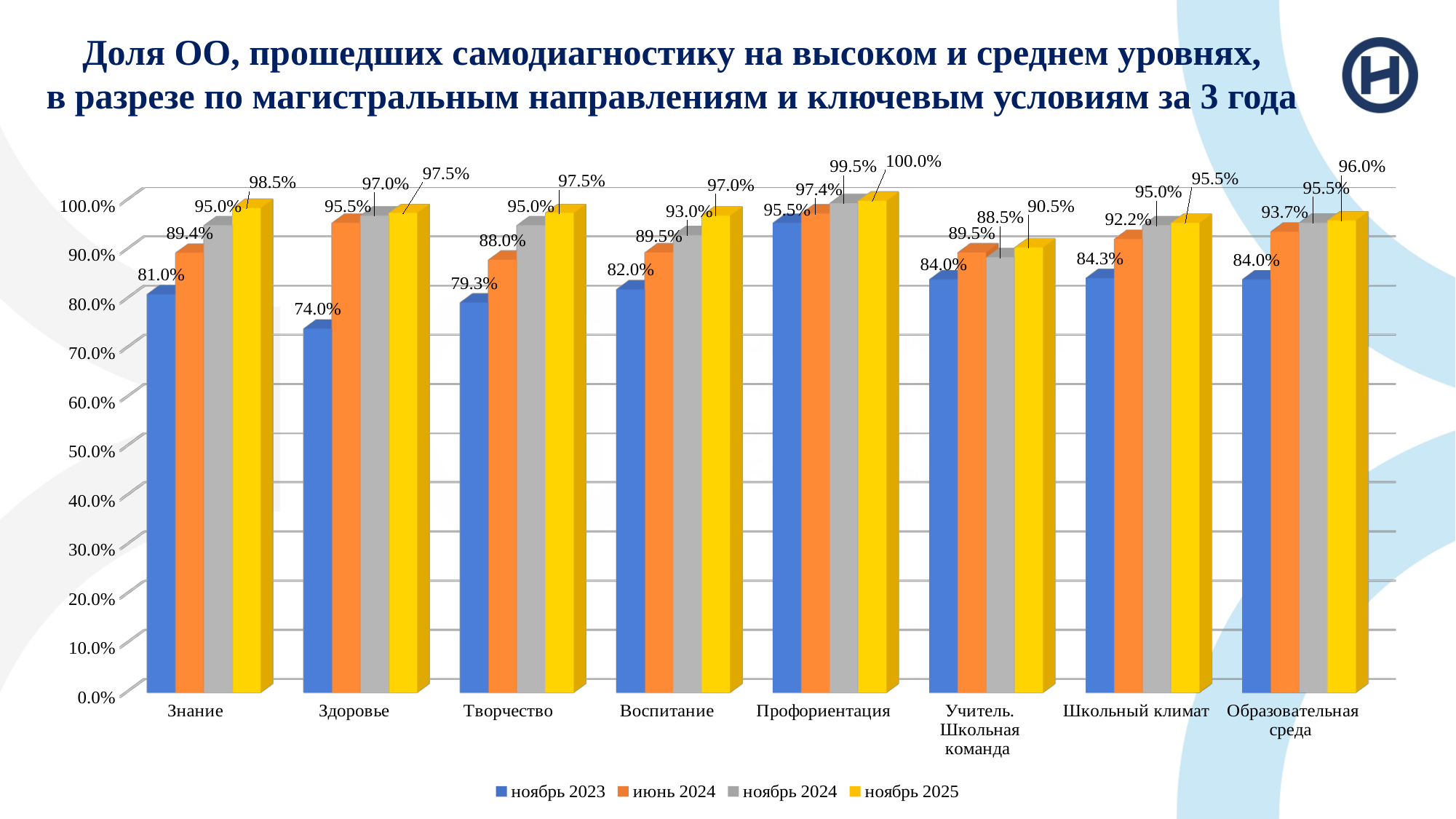
How many categories are shown on the x axis? 8 What is the value for Здоровье in the ноябрь 2023 series? 74.0% Which category has the highest value in the ноябрь 2025 series? Профориентация Which is larger for Учитель. Школьная команда: the июнь 2024 value or the ноябрь 2024 value? июнь 2024 How many series does the legend list? 4 Do the values for Творчество rise or fall from ноябрь 2023 to ноябрь 2025? Rise What kind of chart is shown on the slide? Bar chart Which category has the lowest value in the ноябрь 2023 series? Здоровье What is the value for Школьный климат in the июнь 2024 series? 92.2% What is the value for Профориентация in the ноябрь 2025 series? 100.0% What is the difference between the ноябрь 2025 and ноябрь 2023 values for Знание? 17.5% Which colour represents the ноябрь 2025 series in the legend? Yellow